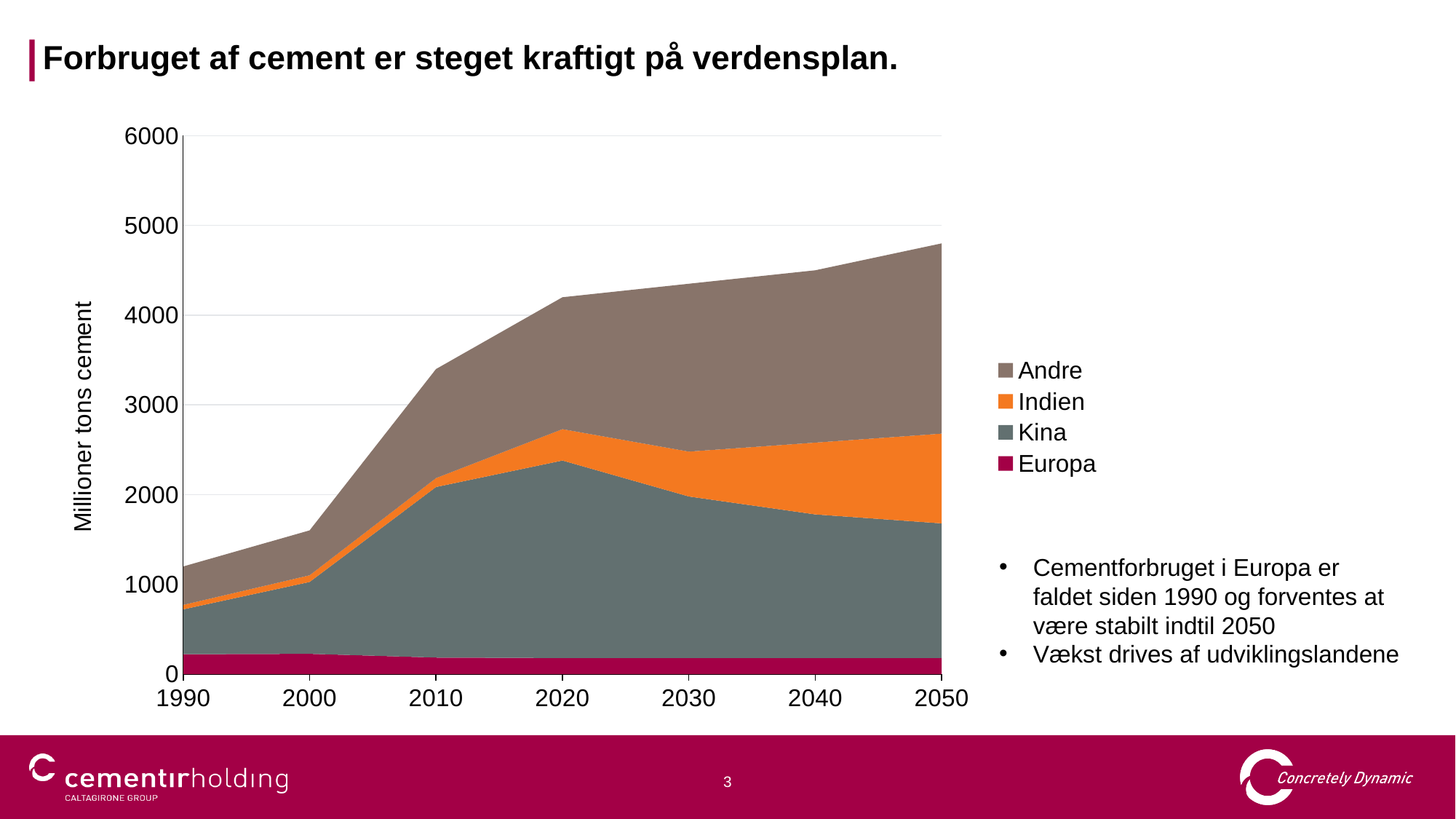
Is the total cement consumption in 2010 greater or less than 3000? greater Does the total cement consumption rise or fall from 1990 to 2050? Rise In which year is the total cement consumption highest? 2050 How many years are marked along the x axis? 7 Is the total cement consumption in 2050 greater or less than 4000? greater Is the total cement consumption in 2000 greater or less than 2000? less What kind of chart is shown on the slide? Stacked area chart How many series does the legend list? 4 Which series is shown at the bottom of the stacked areas? Europa In which year is the total cement consumption lowest? 1990 What is the label of the y axis? Millioner tons cement